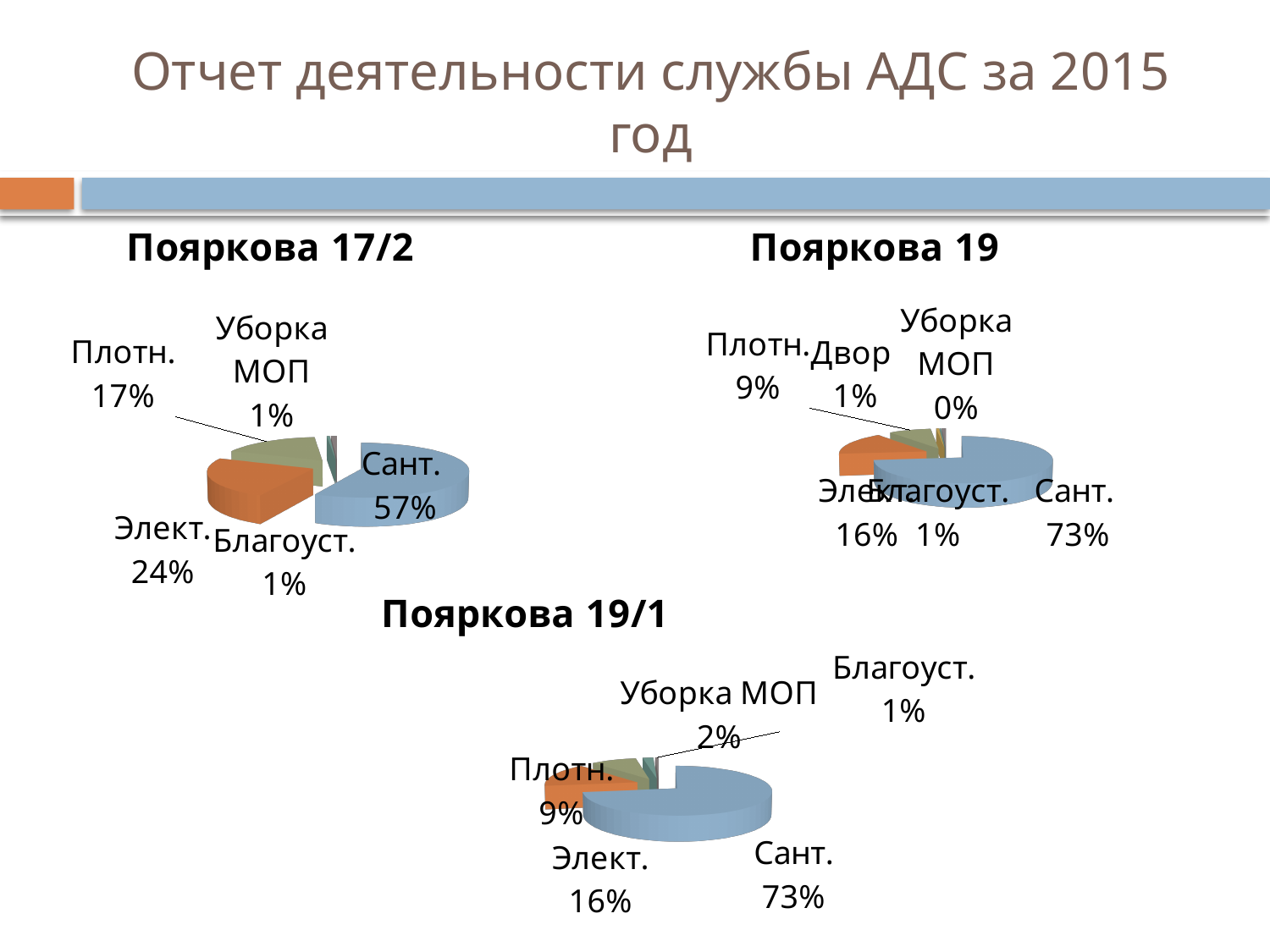
In the "Пояркова 17/2" chart, what is the difference between the shares of Элект. and Плотн.? 7% In the "Пояркова 19/1" chart, what is the difference between the shares of Сант. and Элект.? 57% In the "Пояркова 19" chart, what share does Уборка МОП have? 0% In the "Пояркова 19/1" chart, what share does Уборка МОП have? 2% In the "Пояркова 19" chart, how many categories are labelled? 6 In the "Пояркова 17/2" chart, which category has the largest share? Сант. In the "Пояркова 19" chart, which is larger, Элект. or Плотн.? Элект. In the "Пояркова 19/1" chart, what share does Плотн. have? 9% In the "Пояркова 19" chart, what share does Сант. have? 73% What type of chart is used for "Пояркова 19/1"? Pie chart In the "Пояркова 17/2" chart, what share does Элект. have? 24% In the "Пояркова 17/2" chart, what share does Сант. have? 57%